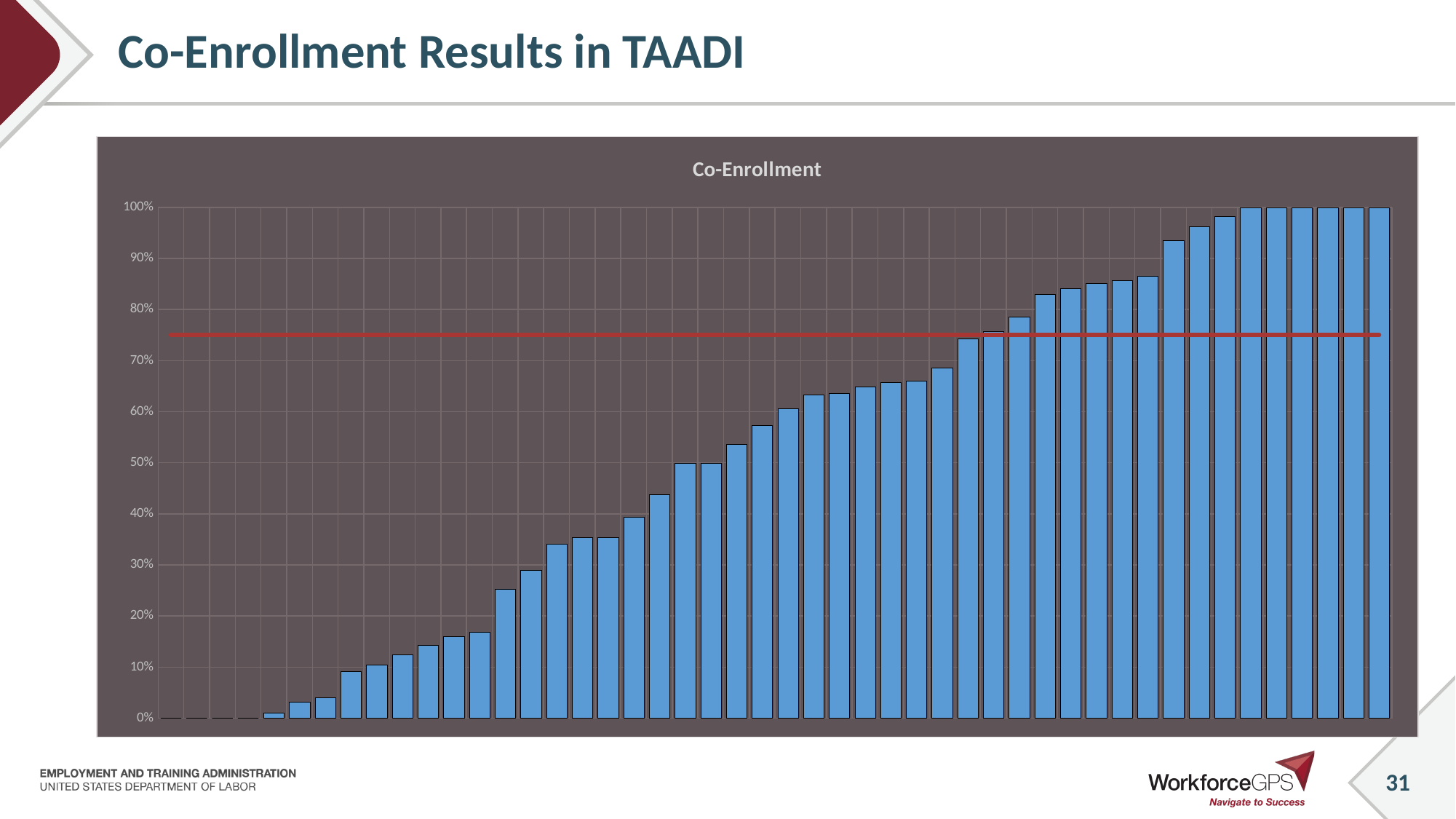
Is the value of the tallest bar greater or less than 90%? greater What is the highest value shown on the y axis? 100% What value does the rightmost bar reach on the y axis? 100% Is the value of the leftmost bar greater or less than 10%? less Is the value of the bar in the middle of the chart greater or less than 90%? less What is the title of the chart? Co-Enrollment Is the red horizontal line drawn above or below the 50% gridline? above What kind of chart is shown on the slide? bar chart Which bar is taller, the leftmost bar or the rightmost bar? the rightmost bar Do the bar values rise or fall from left to right along the x axis? rise